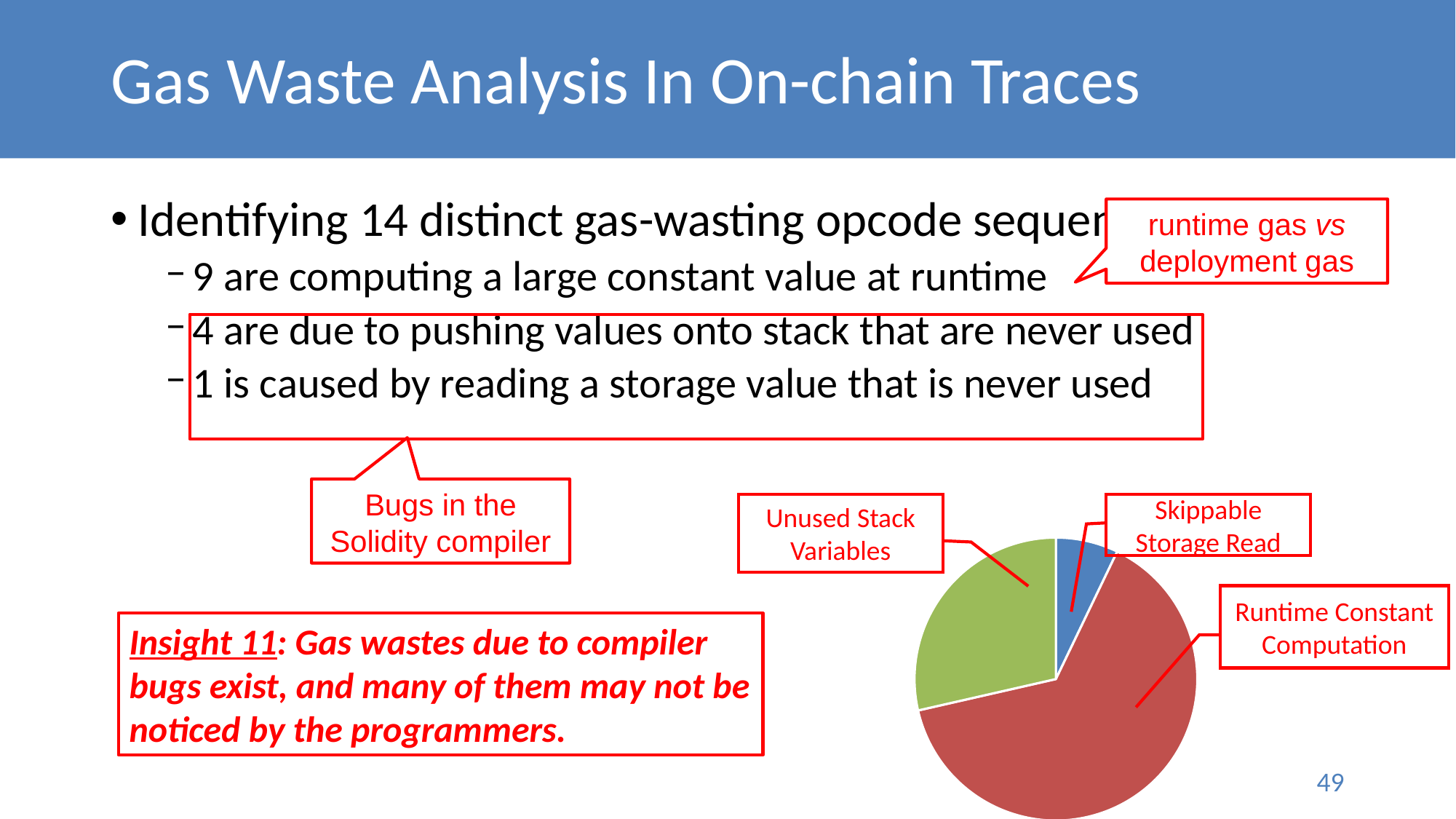
Which category is shown by the green slice in the pie chart? Unused Stack Variables What colour is the Runtime Constant Computation slice in the pie chart? Red How many slices does the pie chart have? 3 What kind of chart is shown on the slide? Pie chart Which category has the largest slice in the pie chart? Runtime Constant Computation Which slice is larger in the pie chart: Unused Stack Variables or Skippable Storage Read? Unused Stack Variables Which category has the smallest slice in the pie chart? Skippable Storage Read Which slice is larger in the pie chart: Runtime Constant Computation or Unused Stack Variables? Runtime Constant Computation